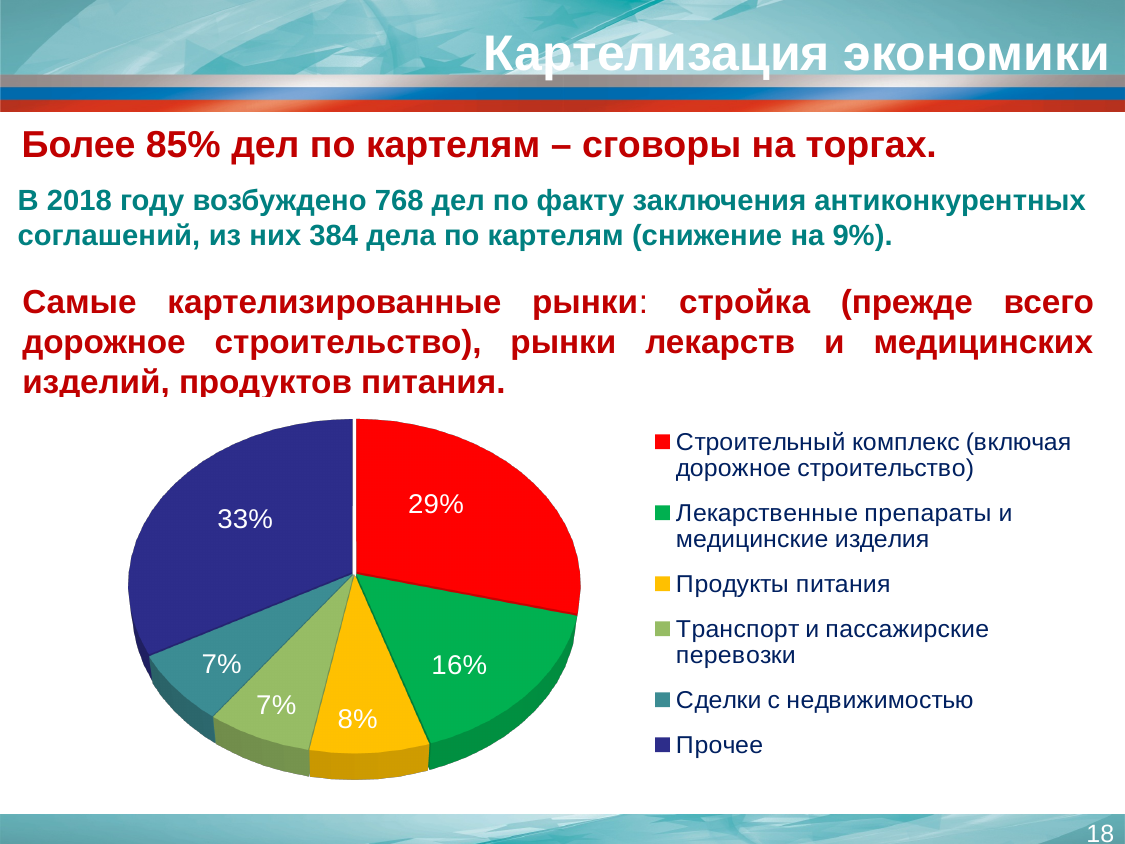
What is the value for Прочее in the pie chart? 33% By how many percentage points does Строительный комплекс exceed Лекарственные препараты и медицинские изделия? 13 How many entries does the legend list? 6 What is the value shown for Лекарственные препараты и медицинские изделия? 16% Which is larger: the slice for Строительный комплекс or the slice for Лекарственные препараты и медицинские изделия? Строительный комплекс How many slices does the pie chart have? 6 What colour is the slice for Продукты питания? Yellow What type of chart is shown on the slide? Pie chart What share of the pie does Строительный комплекс (включая дорожное строительство) have? 29% What percentage is shown for Сделки с недвижимостью? 7% Which category has the largest slice of the pie? Прочее What percentage is shown for Продукты питания? 8%